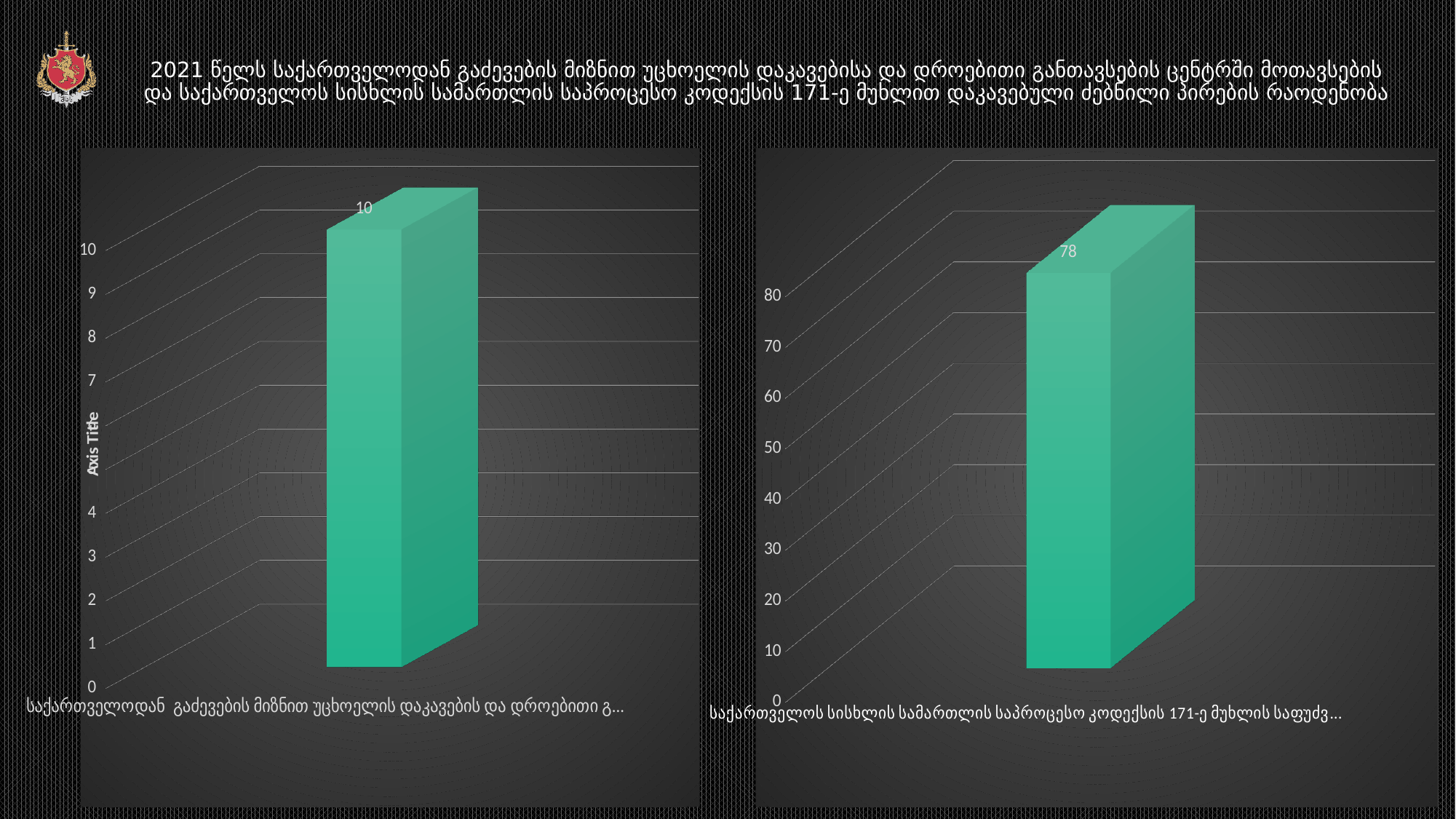
How many bars does the left chart contain? 1 How many bars does the right chart contain? 1 What is the vertical axis title shown on the left chart? Axis Title What kind of chart is the left chart? bar chart What kind of chart is the right chart? bar chart In the right chart, is the value of the bar greater or less than 70? greater What is the highest tick value shown on the vertical axis of the right chart? 80 Which chart shows the larger bar value, the left chart or the right chart? the right chart What is the difference between the bar value in the right chart and the bar value in the left chart? 68 In the left chart, what value is shown on the bar? 10 In the left chart, is the value of the bar greater or less than 5? greater In the right chart, what value is shown on the bar? 78